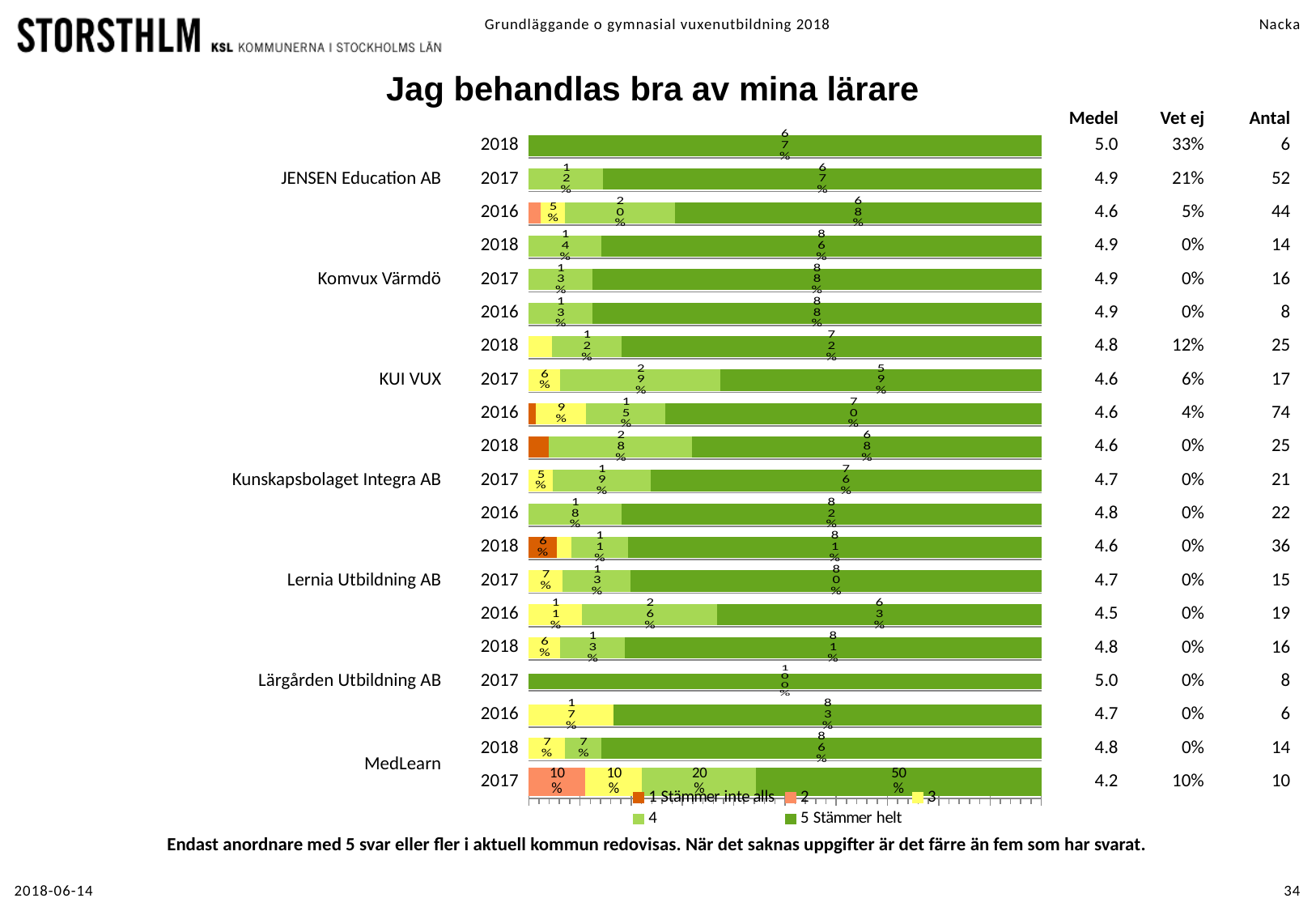
What is the title of the chart? Jag behandlas bra av mina lärare What kind of chart is shown on the slide? bar chart What percentage of JENSEN Education AB respondents in 2018 answered '5 Stämmer helt'? 67% What percentage of Lärgården Utbildning AB respondents in 2017 answered '5 Stämmer helt'? 100% Which provider and year has the highest Antal value? KUI VUX 2016 Which provider and year has the lowest Medel value? MedLearn 2017 What is the Vet ej value for JENSEN Education AB in 2018? 33% How many series does the legend list? 5 What percentage of MedLearn respondents in 2017 answered '5 Stämmer helt'? 50% What is the Medel value for MedLearn in 2017? 4.2 What is the Antal value for KUI VUX in 2016? 74